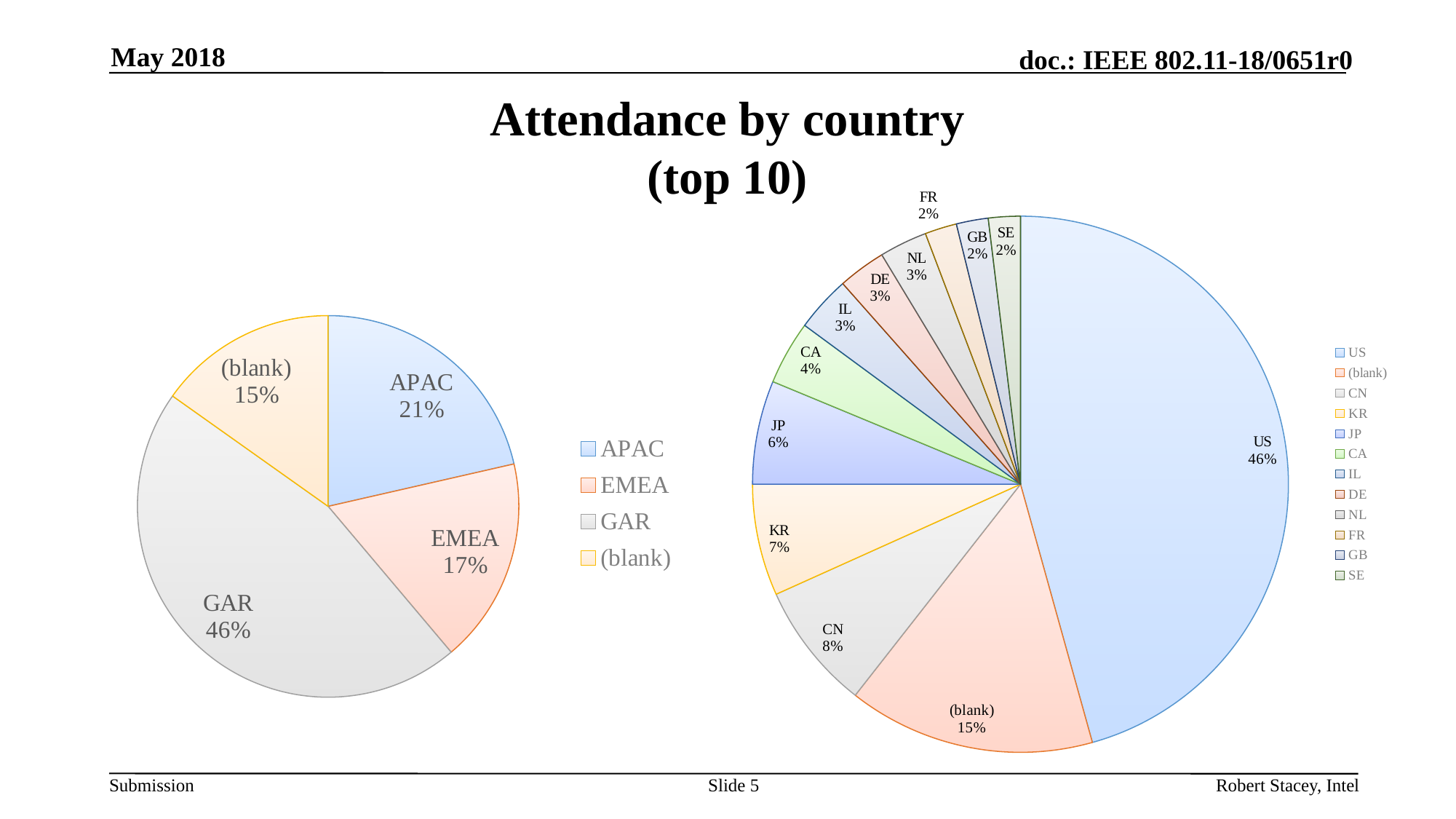
In the right pie chart, what is the difference in percentage points between US and (blank)? 31 In the left pie chart, what share does GAR have? 46% In the right pie chart, which is larger, CN or JP? CN In the left pie chart, what is the difference in percentage points between APAC and EMEA? 4 How many slices does the left pie chart have? 4 In the left pie chart, which region has the largest share? GAR In the right pie chart, what share does the US have? 46% In the left pie chart, what share does EMEA have? 17% What type of chart is the left chart? Pie chart How many entries does the legend of the right pie chart list? 12 In the right pie chart, what share does KR have? 7% In the left pie chart, which slice is the smallest? (blank)